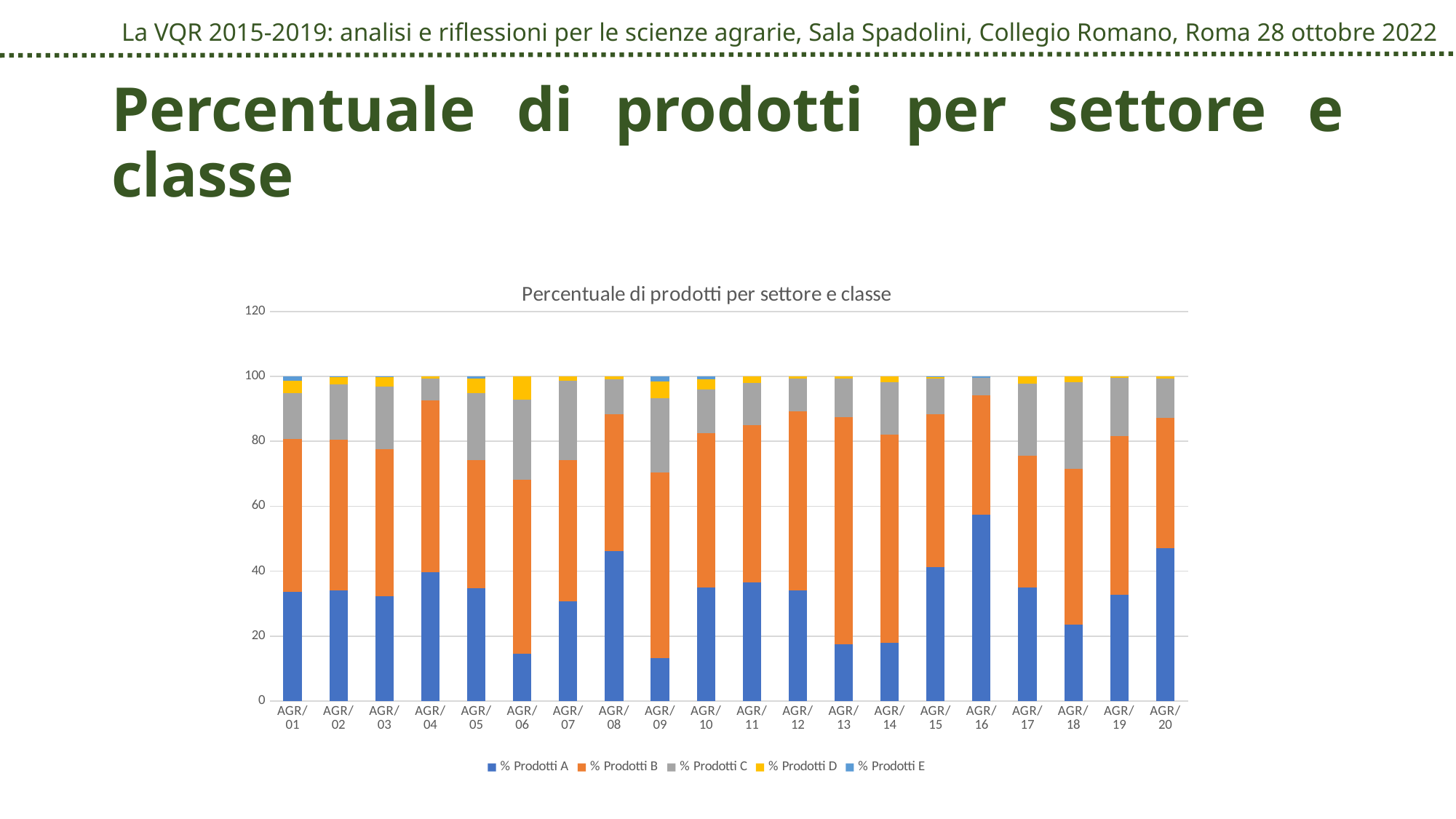
Which sector has a larger % Prodotti A value, AGR/06 or AGR/20? AGR/20 How many categories (sectors) are shown on the x axis of the chart? 20 What kind of chart is shown on the slide? Stacked bar chart What is the title of the chart? Percentuale di prodotti per settore e classe Is the % Prodotti A value for AGR/03 greater or less than 40? less Is the % Prodotti A value for AGR/08 greater or less than 40? greater Is the % Prodotti A value for AGR/16 greater or less than 40? greater Which sector has the highest value for % Prodotti A? AGR/16 How many series does the chart legend list? 5 Which sector has a larger % Prodotti A value, AGR/16 or AGR/01? AGR/16 Which series is shown in orange in the chart? % Prodotti B